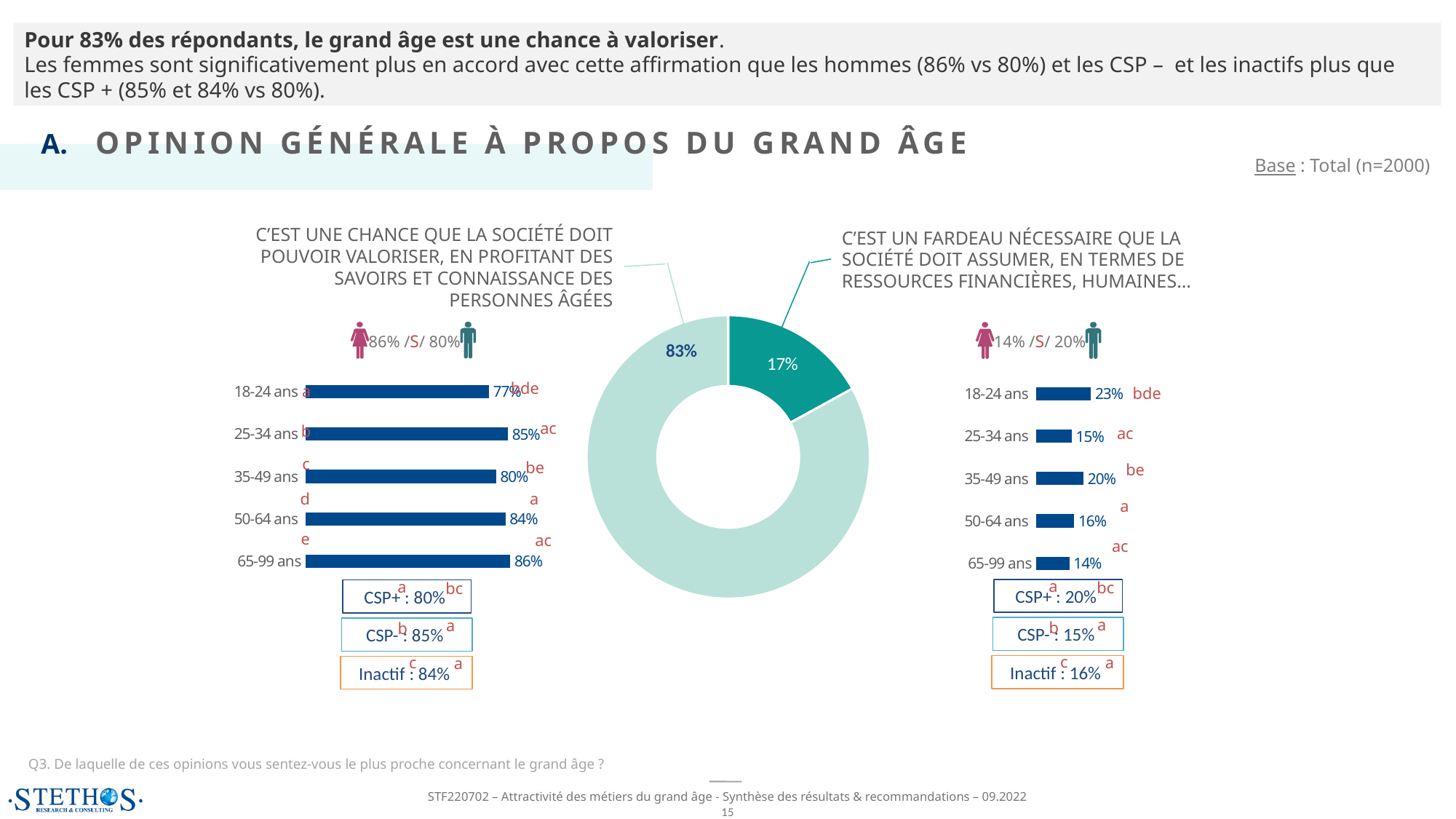
In the right bar chart (fardeau nécessaire), which age group has the highest value? 18-24 ans What kind of chart is used for the age-group breakdowns on the left and right of the slide? Bar chart In the left bar chart (chance à valoriser), which age group has the highest value? 65-99 ans In the left bar chart (chance à valoriser), what is the difference between the values for 65-99 ans and 18-24 ans? 9 percentage points How many age groups are shown in the left bar chart (chance à valoriser)? 5 In the left bar chart (chance à valoriser), what is the value for 18-24 ans? 77% What kind of chart is the central chart on the slide? Donut (pie) chart In the central donut chart, what share of respondents say the grand âge is a necessary burden? 17% In the right bar chart (fardeau nécessaire), which is larger, the value for 25-34 ans or 50-64 ans? 50-64 ans In the left bar chart (chance à valoriser), which age group has the lowest value? 18-24 ans In the right bar chart (fardeau nécessaire), what is the value for 35-49 ans? 20% In the central donut chart, what share of respondents say the grand âge is a chance that society must value? 83%